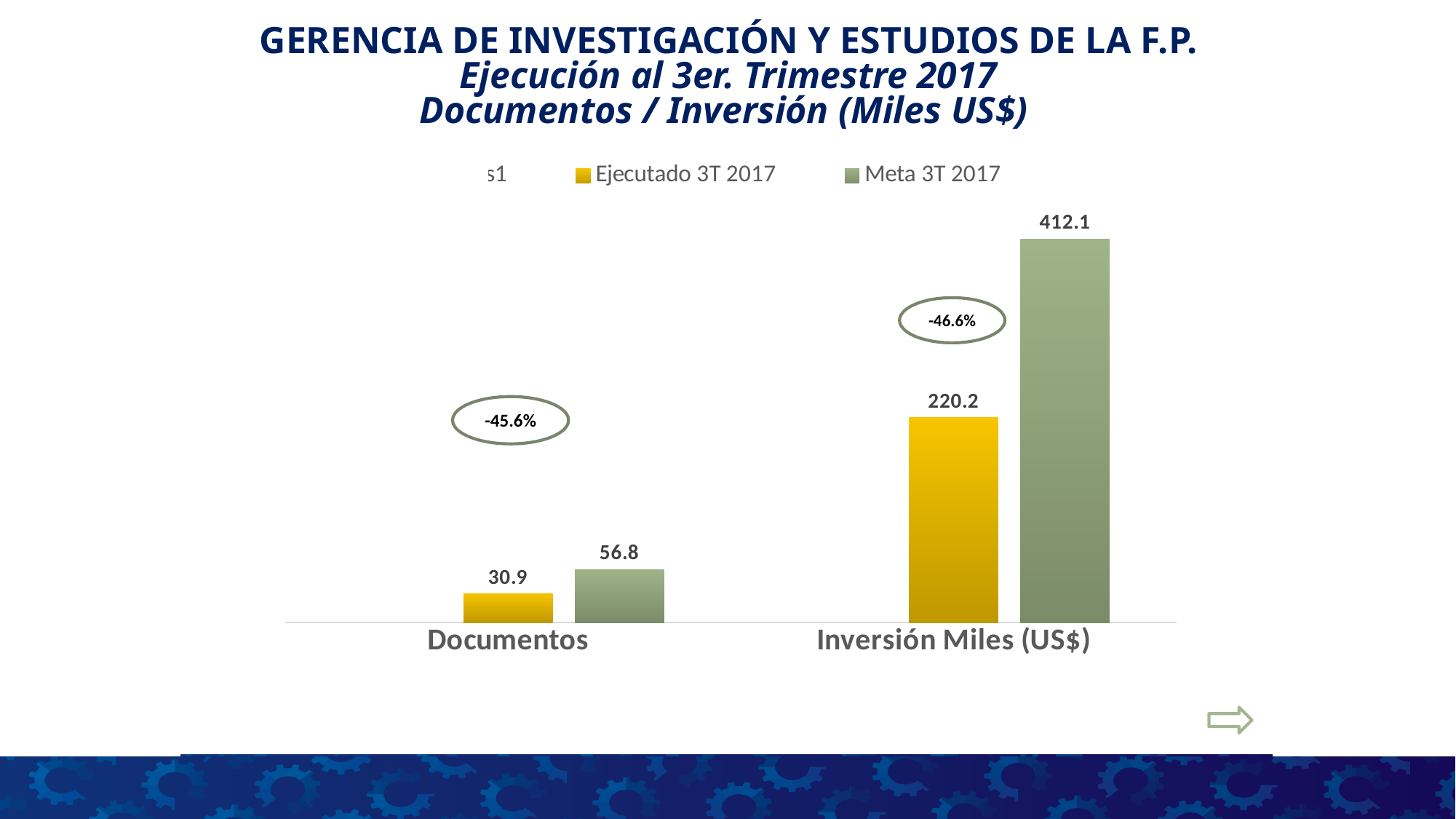
What is the Meta 3T 2017 value for Inversión Miles (US$)? 412.1 What percentage is shown in the oval above the Documentos bars? -45.6% What is the Ejecutado 3T 2017 value for Documentos? 30.9 Which bar has the highest value on the chart? Meta 3T 2017 for Inversión Miles (US$) How many series does the legend list? 3 What is the difference between the Meta 3T 2017 and Ejecutado 3T 2017 values for Documentos? 25.9 What percentage is shown in the oval above the Inversión Miles (US$) bars? -46.6% What kind of chart is shown on the slide? Bar chart What is the Meta 3T 2017 value for Documentos? 56.8 What is the Ejecutado 3T 2017 value for Inversión Miles (US$)? 220.2 What is the difference between the Meta 3T 2017 and Ejecutado 3T 2017 values for Inversión Miles (US$)? 191.9 For Documentos, which is larger: Ejecutado 3T 2017 or Meta 3T 2017? Meta 3T 2017